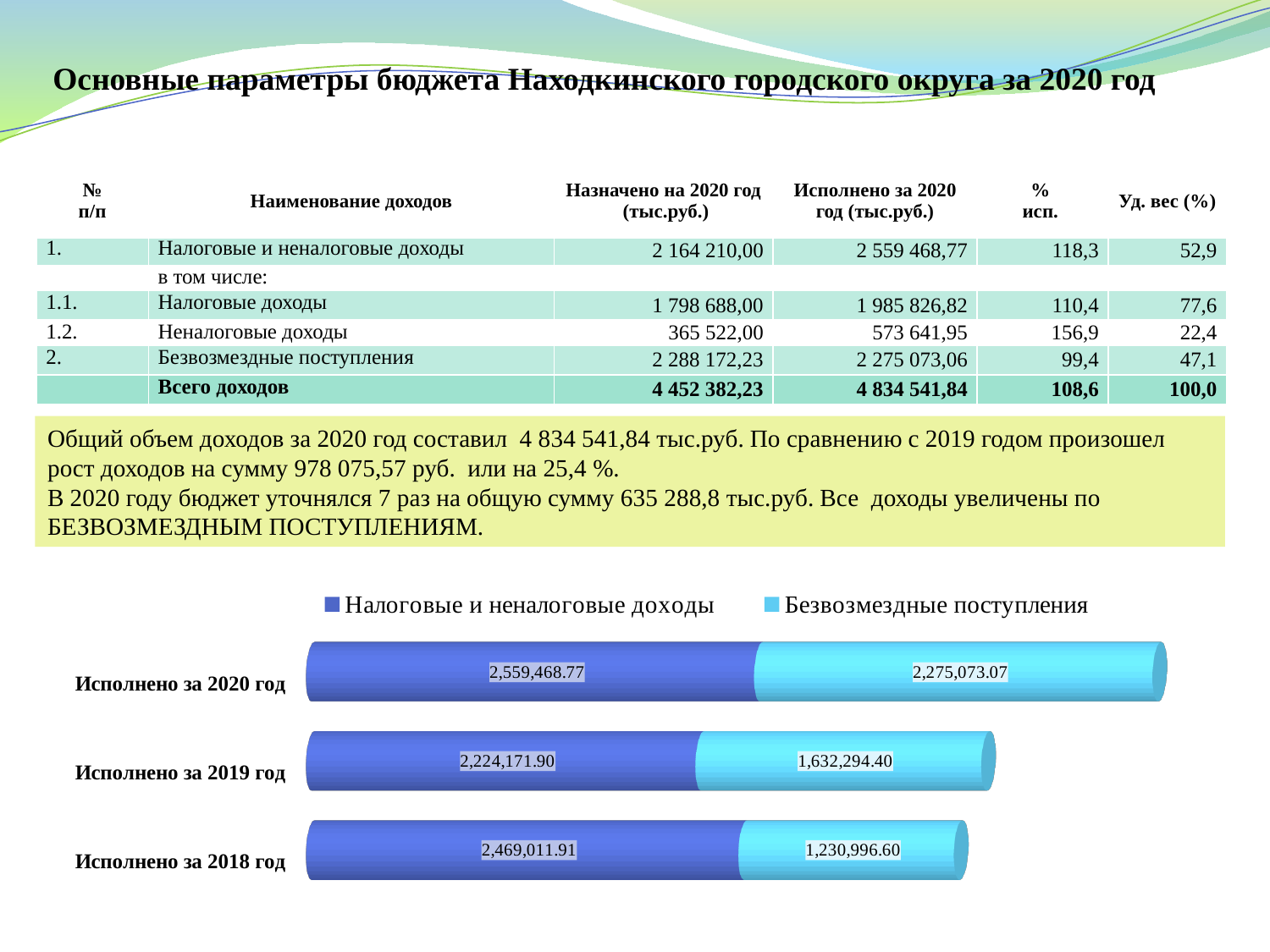
What is the value of Безвозмездные поступления for Исполнено за 2019 год? 1,632,294.40 Which is larger: Налоговые и неналоговые доходы for 2018 or for 2019? 2018 How many categories (years) are shown in the chart? 3 What is the value of Безвозмездные поступления for Исполнено за 2018 год? 1,230,996.60 How many series does the chart legend list? 2 Which year has the highest value for Безвозмездные поступления? Исполнено за 2020 год What type of chart is shown at the bottom of the slide? Stacked bar chart Which year has the lowest value for Налоговые и неналоговые доходы? Исполнено за 2019 год Do the values for Безвозмездные поступления rise or fall from 2018 to 2020? Rise What is the difference between Безвозмездные поступления for 2020 and for 2019? 642,778.67 What is the total of the stacked bar for Исполнено за 2020 год? 4,834,541.84 What is the value of Налоговые и неналоговые доходы for Исполнено за 2020 год? 2,559,468.77